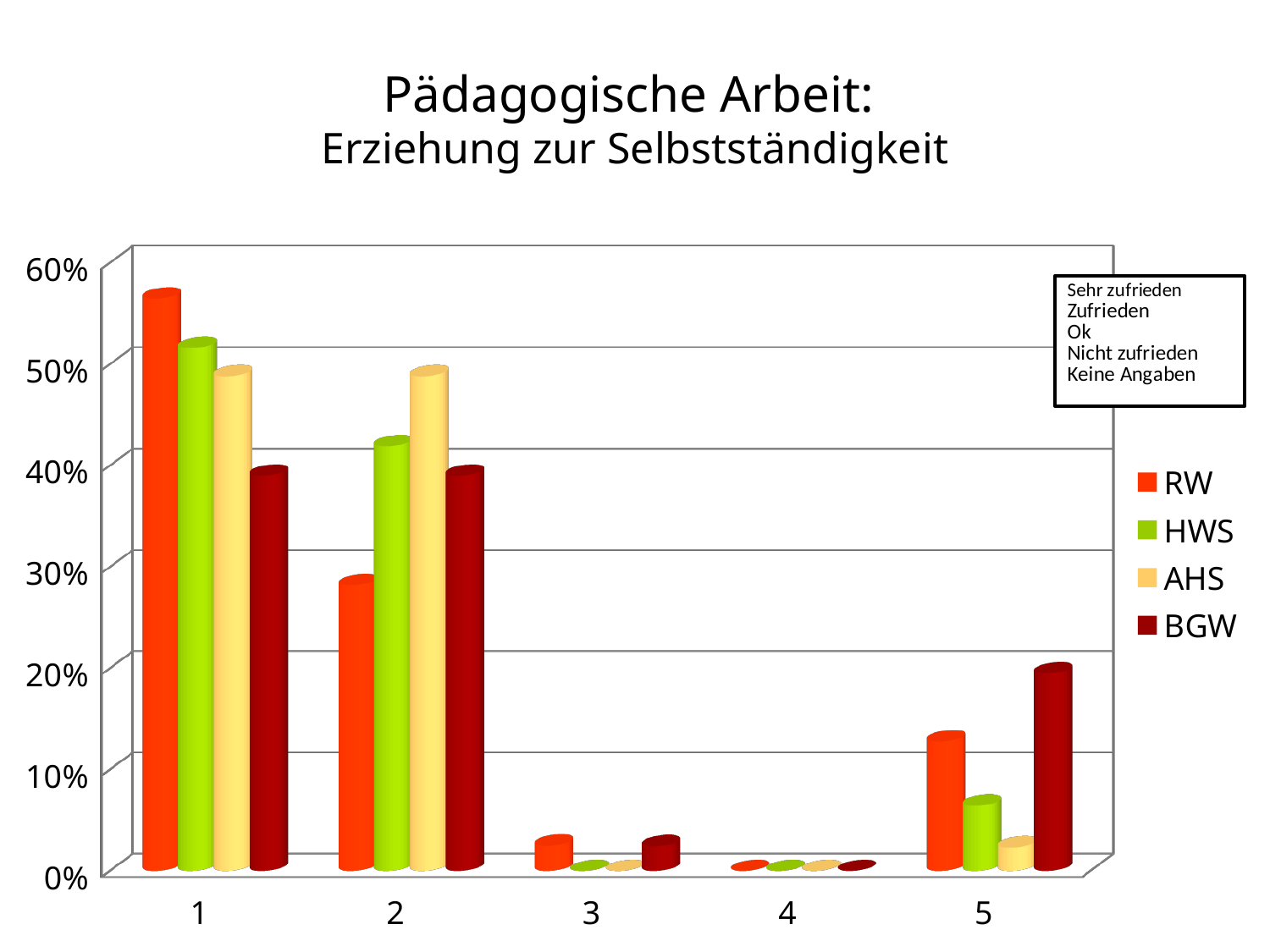
In category 2, which is larger: HWS or RW? HWS Which series has the lowest value in category 1? BGW Is the value for RW in category 2 greater or less than 30%? less Is the value for RW in category 1 greater or less than 50%? greater Which series is shown in dark red in the legend? BGW What is the title of the chart? Pädagogische Arbeit: Erziehung zur Selbstständigkeit What kind of chart is shown on the slide? bar chart How many categories are shown on the x axis? 5 Is the value for BGW in category 5 greater or less than 10%? greater Which series has the highest value in category 1? RW Which series has the highest value in category 5? BGW How many series does the legend list? 4